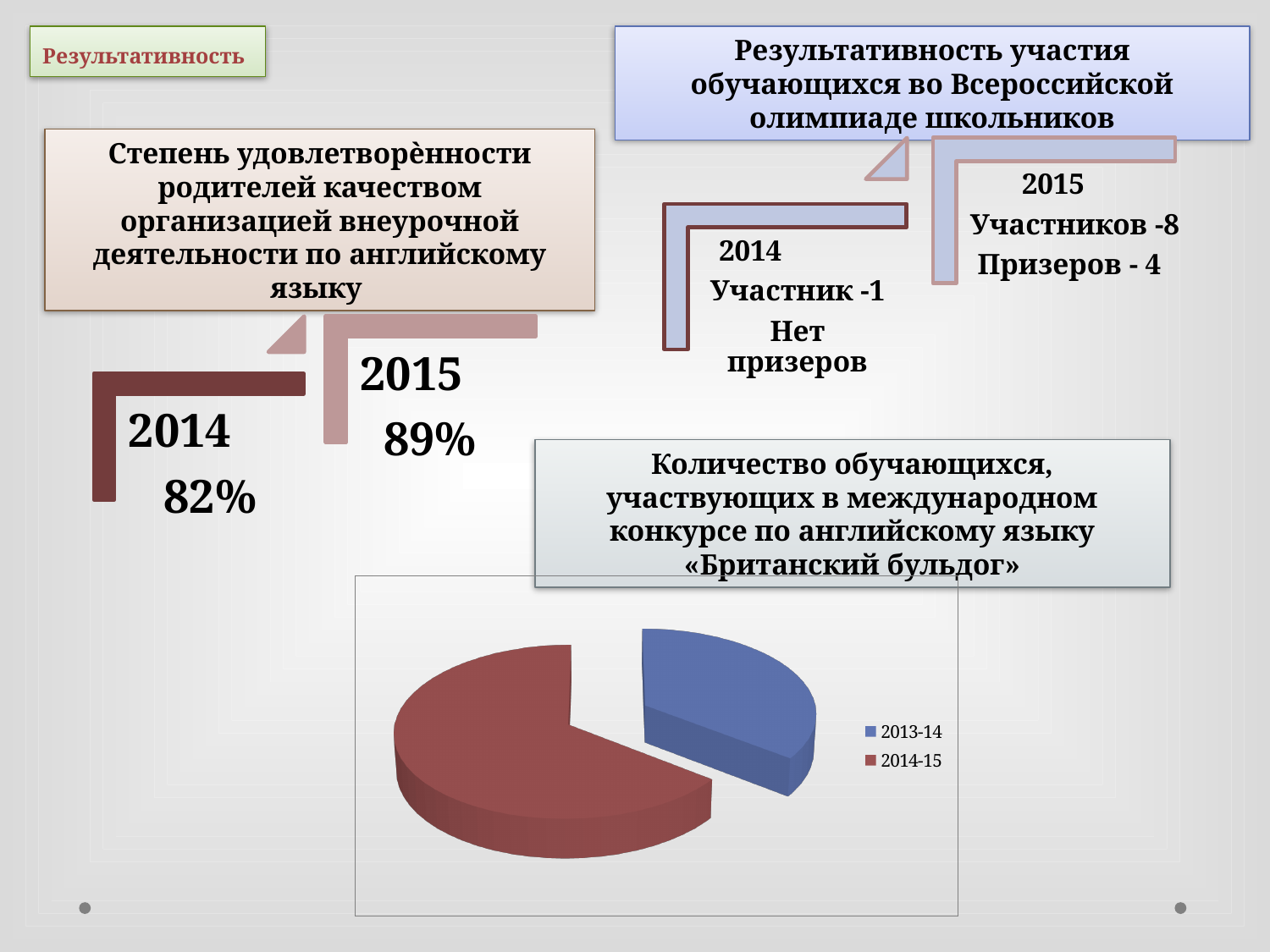
How many slices does the pie chart have? 2 In the pie chart, which slice is larger: 2013-14 or 2014-15? 2014-15 Which category has the largest slice in the pie chart? 2014-15 Which category has the smallest slice in the pie chart? 2013-14 What are the two legend entries of the pie chart? 2013-14 and 2014-15 How many entries does the legend of the pie chart list? 2 Does the 2014-15 slice take up more or less than half of the pie chart? more What kind of chart is shown at the bottom of the slide? pie chart What colour is the 2013-14 slice in the pie chart? blue